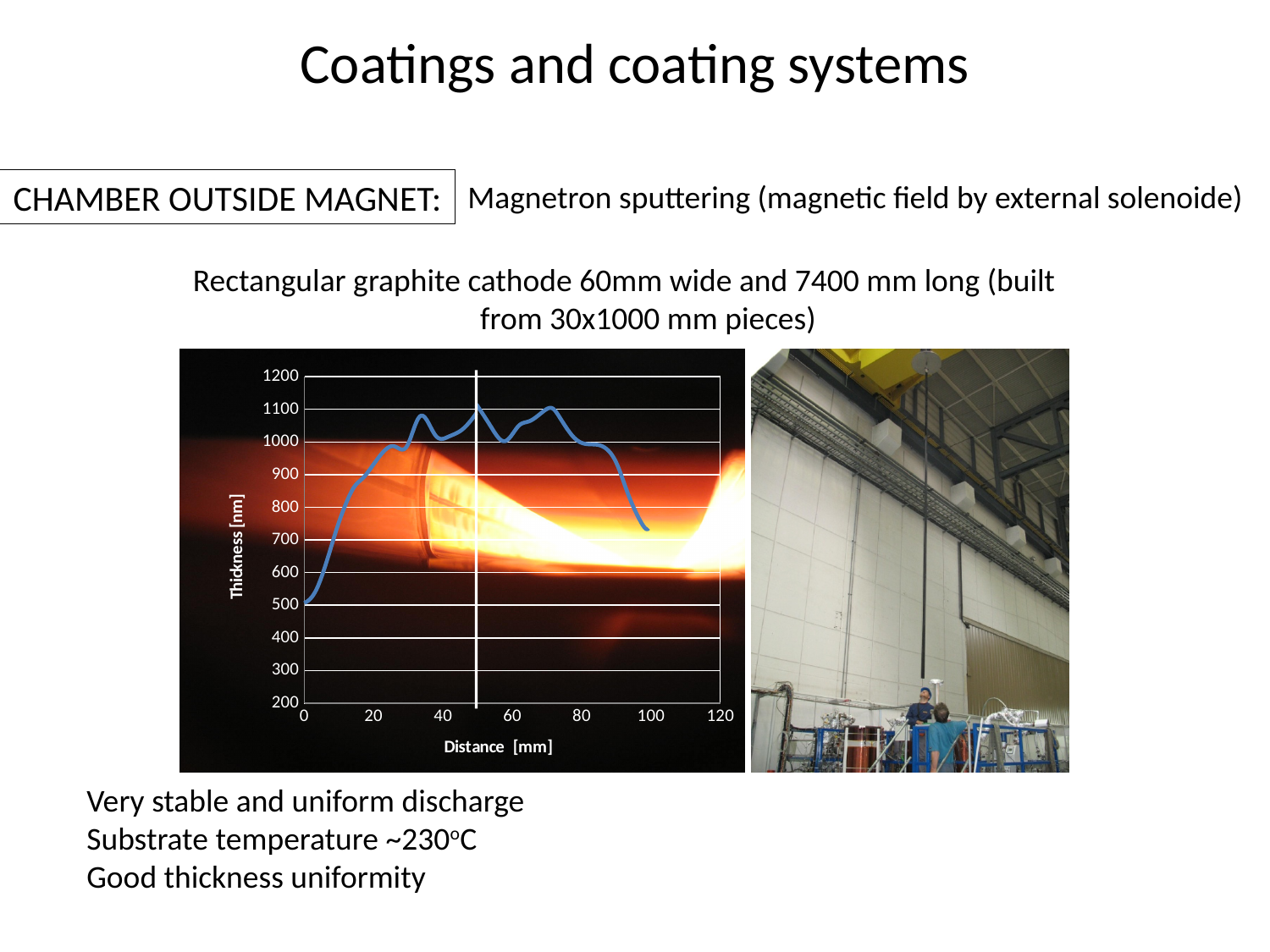
Does the thickness rise or fall as the distance increases from 70 mm to 100 mm? fall Is the thickness at a distance of 100 mm greater or less than 800 nm? less At which distance is the plotted thickness lowest? 0 mm What is the label of the horizontal axis of the chart? Distance [mm] What kind of chart is shown on the slide? line chart Is the thickness at a distance of 0 mm greater or less than 600 nm? less Is the thickness at a distance of 70 mm greater or less than 1000 nm? greater Does the thickness rise or fall as the distance increases from 0 mm to 50 mm? rise What is the label of the vertical axis of the chart? Thickness [nm] Which is larger, the thickness at a distance of 50 mm or at a distance of 100 mm? 50 mm